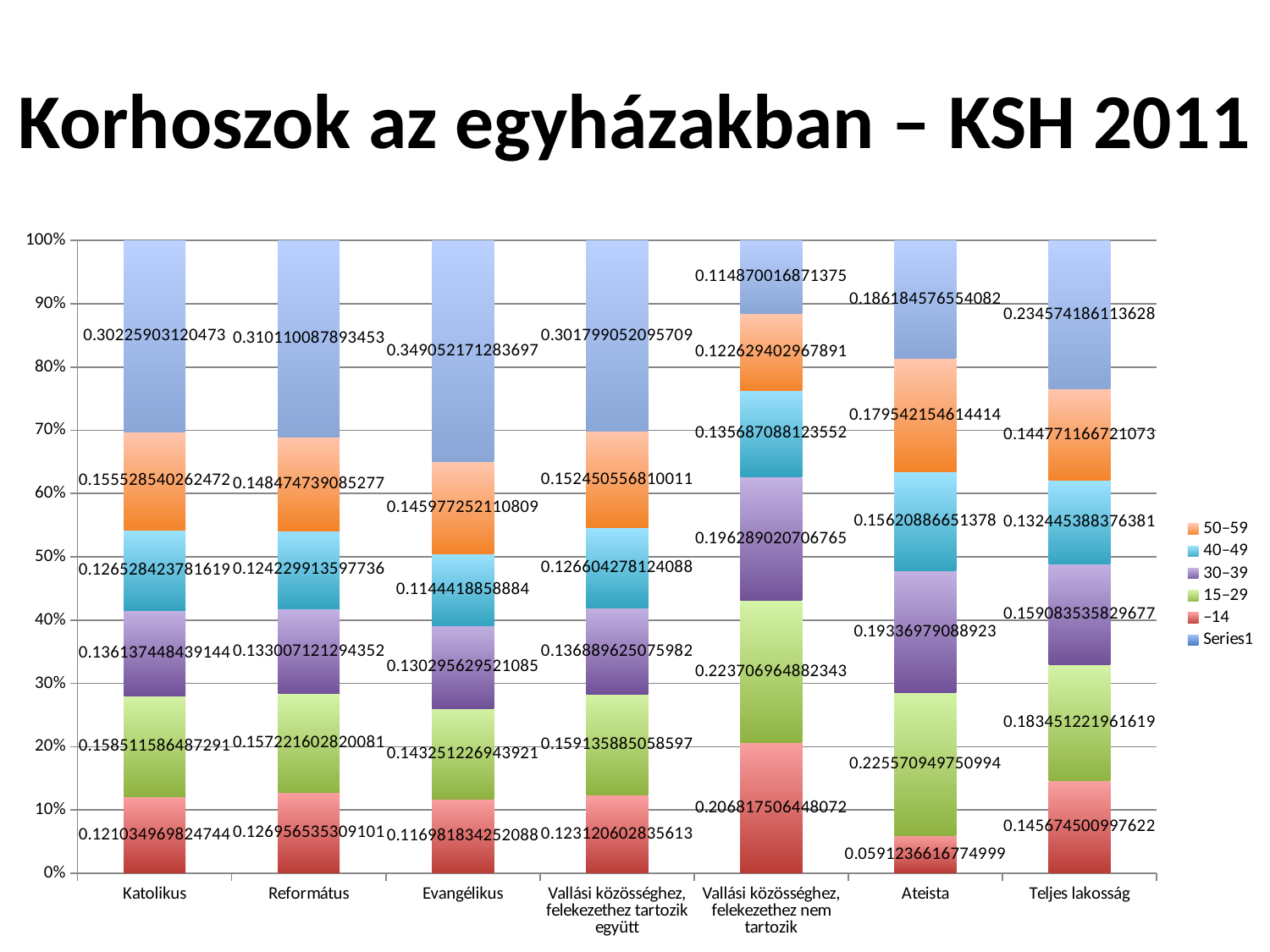
Which category has the highest value for Series1? Evangélikus What is the value of the –14 series for Ateista? 0.0591236616774999 Which category has the lowest value for the –14 series? Ateista How many categories are shown along the x axis? 7 What is the title of the chart on the slide? Korhoszok az egyházakban – KSH 2011 Which category has the highest value for the 15–29 series? Ateista What is the value of the 50–59 series for Katolikus? 0.155528540262472 How many series does the legend list? 6 What kind of chart is shown on the slide? Stacked bar chart What is the value of the Series1 segment for Evangélikus? 0.349052171283697 What is the value of the 15–29 series for Teljes lakosság? 0.183451221961619 Which is larger: the 30–39 value for Ateista or the 30–39 value for Katolikus? Ateista